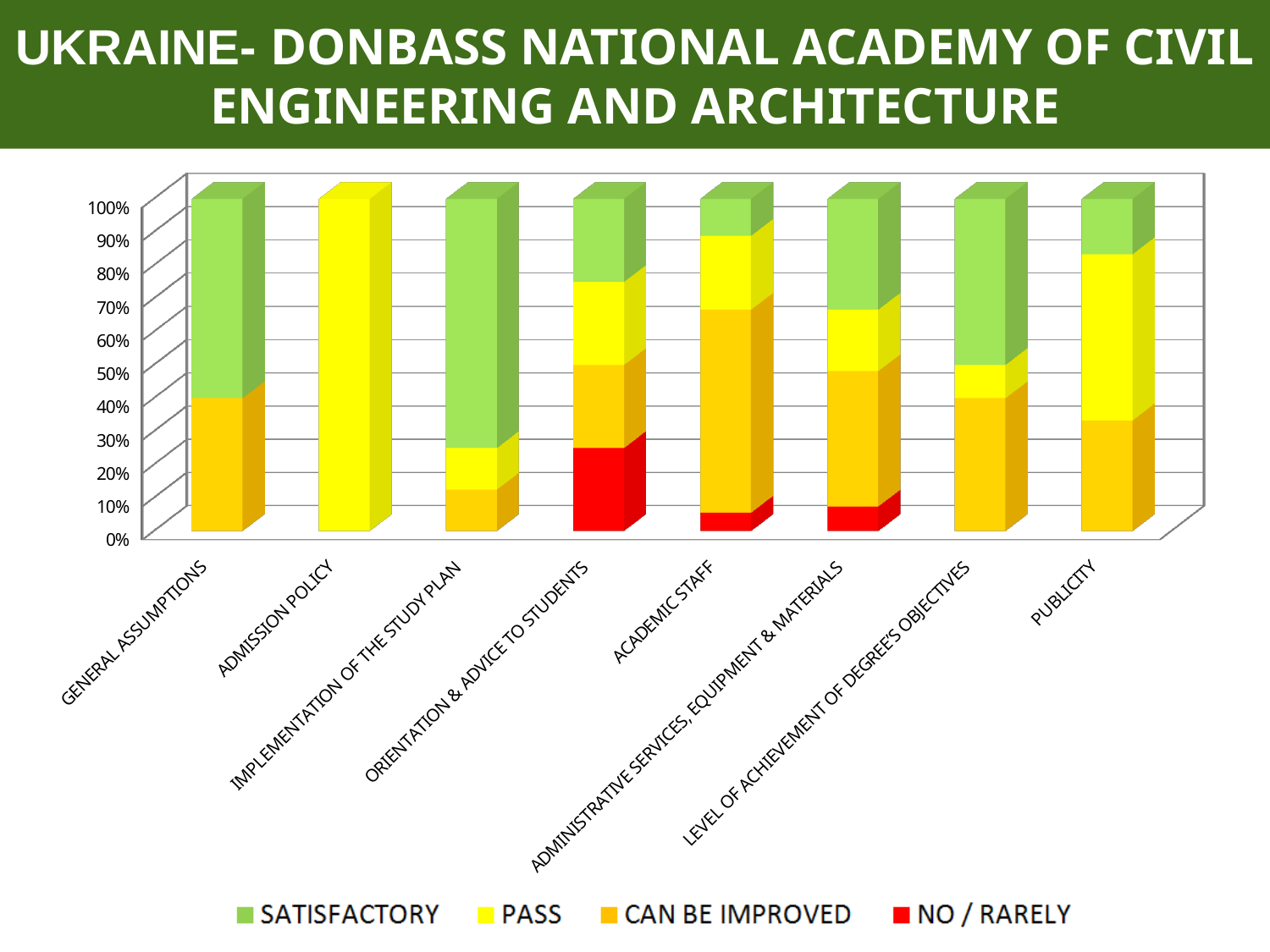
Is the SATISFACTORY value for GENERAL ASSUMPTIONS greater or less than 50%? greater Is the SATISFACTORY value for ACADEMIC STAFF greater or less than 20%? less How many categories are shown along the x axis of the chart? 8 Which has a larger SATISFACTORY segment, IMPLEMENTATION OF THE STUDY PLAN or PUBLICITY? IMPLEMENTATION OF THE STUDY PLAN Which category has the largest SATISFACTORY segment? IMPLEMENTATION OF THE STUDY PLAN Which category has the largest NO / RARELY segment? ORIENTATION & ADVICE TO STUDENTS How many categories include a NO / RARELY segment? 3 How many series does the chart legend list? 4 What is the PASS value for ADMISSION POLICY? 100% Which colour represents the CAN BE IMPROVED series in the legend? Orange What kind of chart is shown on the slide? Stacked bar chart Is the CAN BE IMPROVED value for ACADEMIC STAFF greater or less than 50%? greater